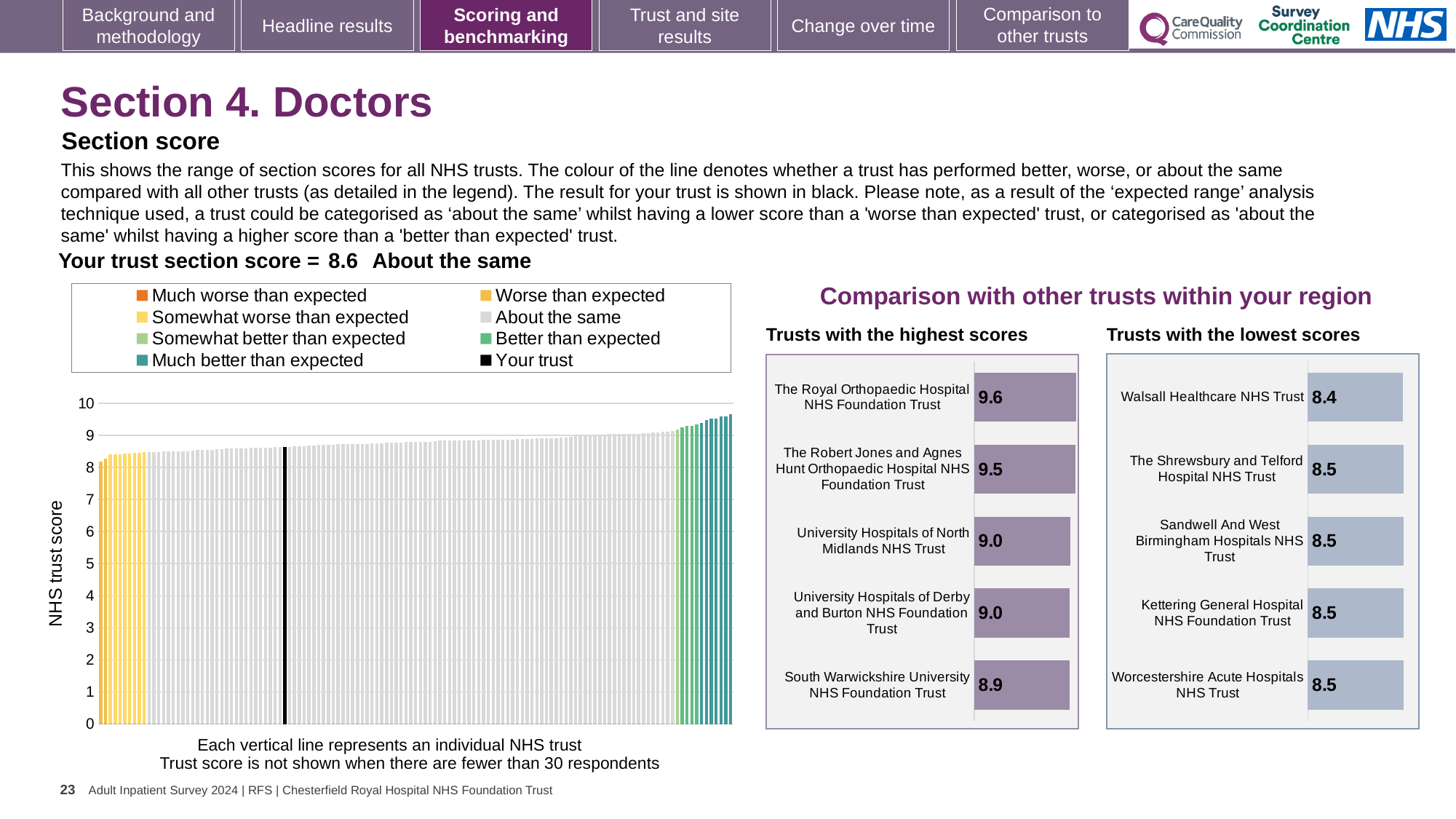
In the 'Trusts with the lowest scores' chart, what is the score for Walsall Healthcare NHS Trust? 8.4 In the 'Trusts with the lowest scores' chart, which trust has the lowest score? Walsall Healthcare NHS Trust How many trusts are shown in the 'Trusts with the highest scores' chart? 5 In the 'Trusts with the highest scores' chart, which is larger: the score for The Robert Jones and Agnes Hunt Orthopaedic Hospital NHS Foundation Trust or University Hospitals of North Midlands NHS Trust? The Robert Jones and Agnes Hunt Orthopaedic Hospital NHS Foundation Trust What is the label on the vertical axis of the left-hand chart? NHS trust score In the 'Trusts with the highest scores' chart, what is the difference between the scores of The Royal Orthopaedic Hospital NHS Foundation Trust and South Warwickshire University NHS Foundation Trust? 0.7 What kind of chart is the large chart on the left showing NHS trust scores? bar chart In the 'Trusts with the highest scores' chart, which trust has the lowest score? South Warwickshire University NHS Foundation Trust In the left-hand chart, do the trust scores rise or fall from left to right? rise In the 'Trusts with the highest scores' chart, what is the score for The Royal Orthopaedic Hospital NHS Foundation Trust? 9.6 What is the section score for your trust shown on the slide? 8.6 How many entries does the legend of the left-hand chart list? 8